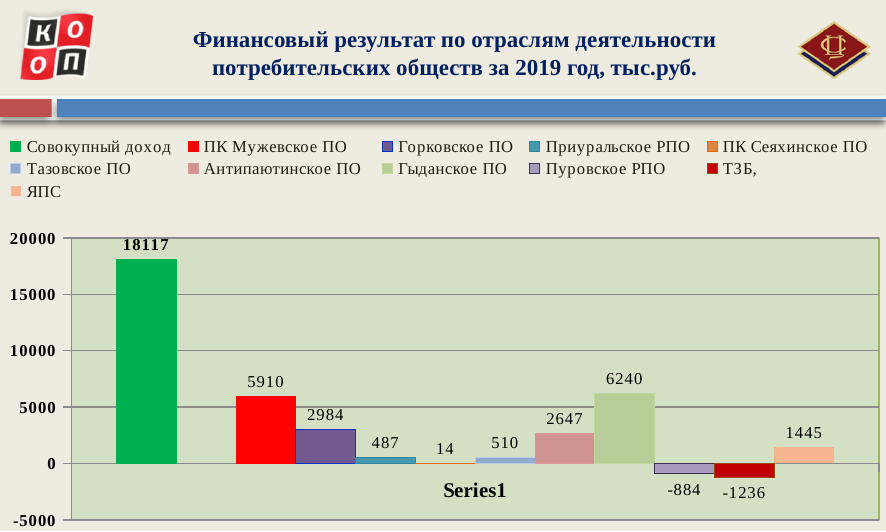
Which category has the highest value? Совокупный доход What is the title of the chart? Финансовый результат по отраслям деятельности потребительских обществ за 2019 год, тыс.руб. What is the value for ПК Сеяхинское ПО? 14 What is the value for Гыданское ПО? 6240 Is the value for ПК Мужевское ПО greater or less than 5000? greater What is the value for Совокупный доход? 18117 What kind of chart is shown on the slide? bar chart What is the difference between the values for Гыданское ПО and ПК Мужевское ПО? 330 Which category has the lowest value? ТЗБ What is the value for ТЗБ? -1236 Which is larger, the value for Горковское ПО or the value for Антипаютинское ПО? Горковское ПО How many entries does the legend list? 11